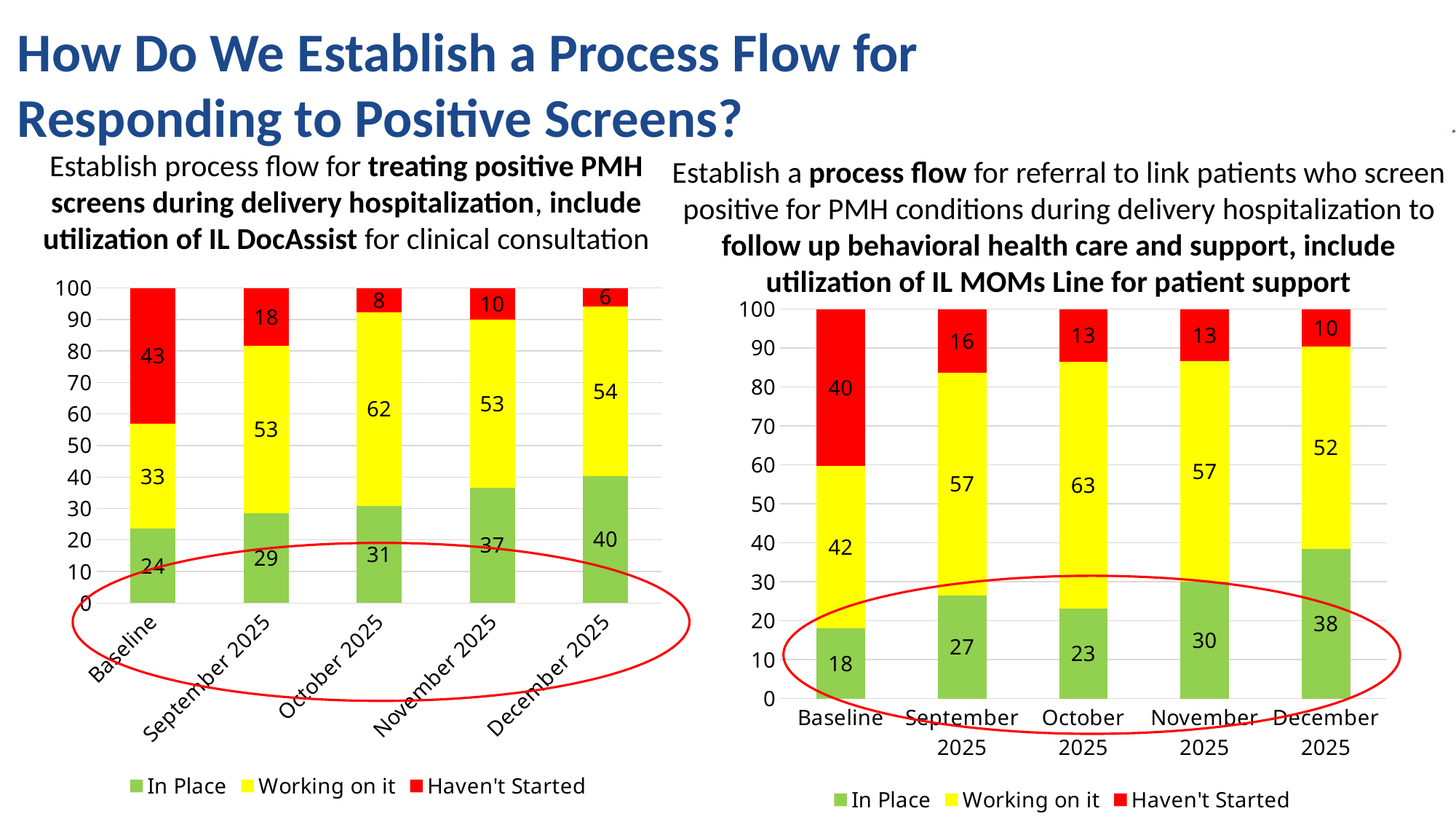
In the left chart, does the 'In Place' value rise or fall from Baseline to December 2025? Rise In the left chart, what is the total of the stacked bar for Baseline? 100 In the right chart, which period has the highest 'In Place' value? December 2025 How many series does the legend of the left chart list? 3 In the right chart, what is the 'Haven't Started' value for Baseline? 40 What type of chart is the right chart? Stacked bar chart In the left chart, what is the 'Working on it' value for October 2025? 62 In the left chart, which period has the lowest 'Haven't Started' value? December 2025 In the left chart, what is the 'In Place' value for December 2025? 40 In the right chart, what is the difference between the 'In Place' values for December 2025 and Baseline? 20 In the left chart, is the 'In Place' value larger for November 2025 or September 2025? November 2025 How many periods are shown on the x axis of the right chart? 5